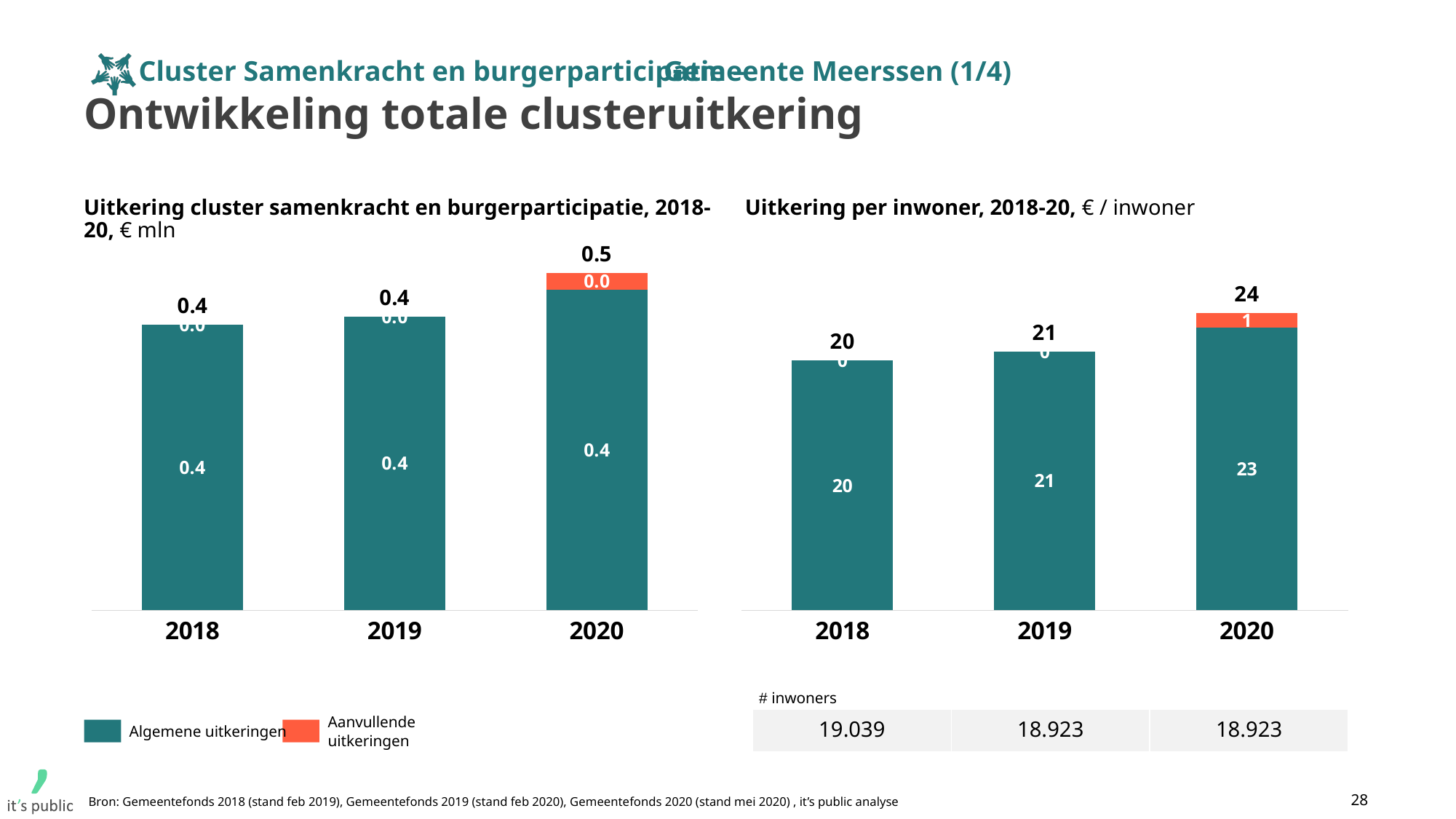
In the chart 'Uitkering cluster samenkracht en burgerparticipatie, 2018-20', what is the value of Algemene uitkeringen for 2018? 0.4 In the chart 'Uitkering per inwoner, 2018-20', what is the value of Algemene uitkeringen for 2019? 21 In the chart 'Uitkering per inwoner, 2018-20', what is the value of Aanvullende uitkeringen for 2020? 1 In the chart 'Uitkering per inwoner, 2018-20', which year has the lowest total value? 2018 In the chart 'Uitkering per inwoner, 2018-20', is the total for 2019 larger or smaller than the total for 2020? smaller How many series does the legend list for the charts on the slide? 2 How many years are shown on the x axis of the chart 'Uitkering cluster samenkracht en burgerparticipatie, 2018-20'? 3 In the chart 'Uitkering per inwoner, 2018-20', which year has the highest total value? 2020 What type of chart is 'Uitkering per inwoner, 2018-20'? Stacked bar chart In the chart 'Uitkering cluster samenkracht en burgerparticipatie, 2018-20', what is the total value for 2020? 0.5 In the chart 'Uitkering per inwoner, 2018-20', what is the difference between the total for 2020 and the total for 2018? 4 In the chart 'Uitkering per inwoner, 2018-20', what is the total value for 2020? 24